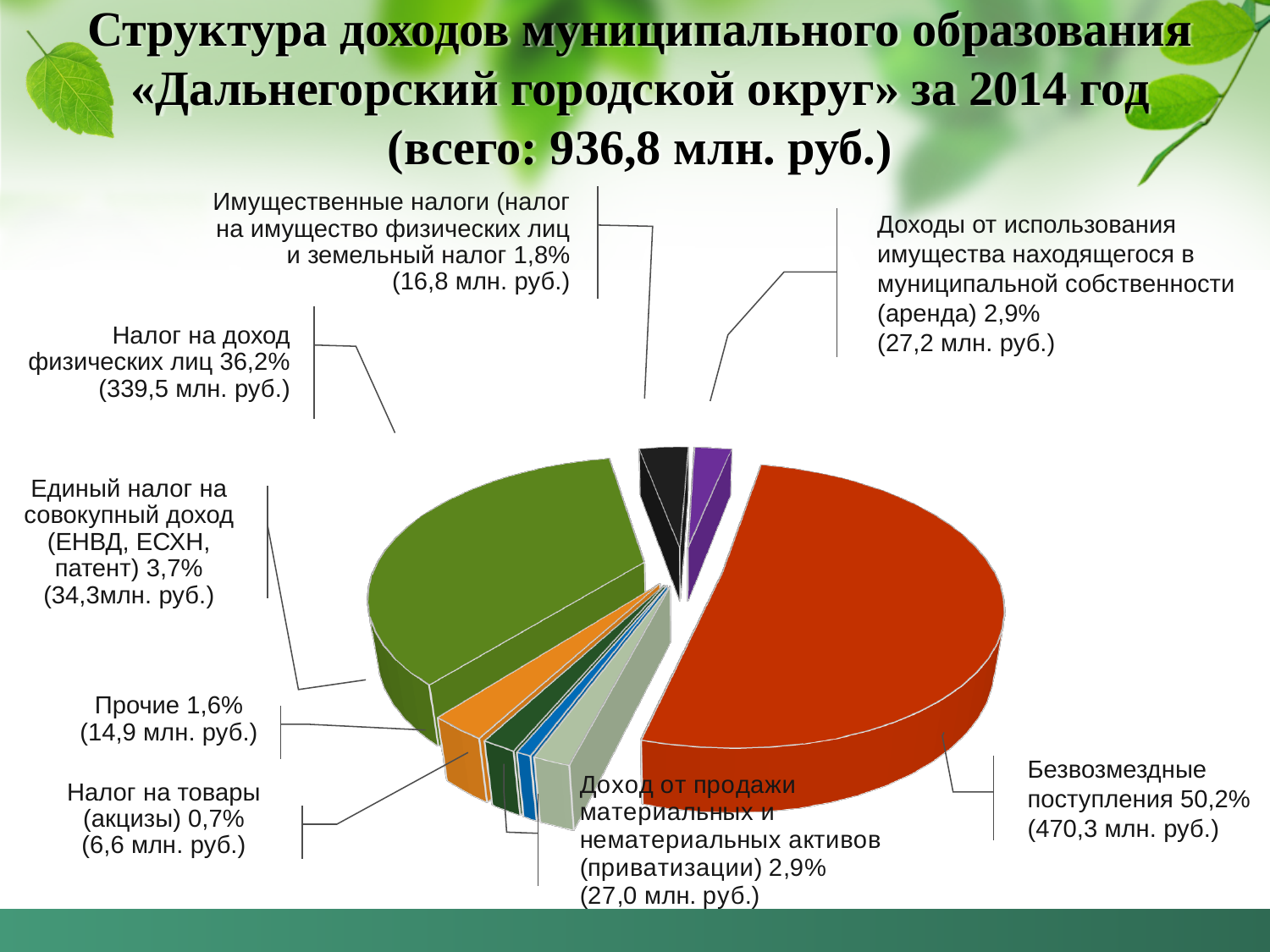
What is the difference in млн. руб. between "Безвозмездные поступления" and "Налог на доход физических лиц"? 130,8 млн. руб. How many categories (slices) does the pie chart have? 8 What kind of chart is shown on the slide? pie chart What is the value in млн. руб. for "Прочие"? 14,9 млн. руб. What share of the pie does "Безвозмездные поступления" represent? 50,2% What is the value in млн. руб. for "Доходы от использования имущества находящегося в муниципальной собственности (аренда)"? 27,2 млн. руб. What percentage share is shown for "Единый налог на совокупный доход (ЕНВД, ЕСХН, патент)"? 3,7% Which category has the largest share of the pie? Безвозмездные поступления Which is larger: "Имущественные налоги" or "Прочие"? Имущественные налоги What is the value in млн. руб. for "Налог на доход физических лиц"? 339,5 млн. руб. What total amount of income is stated in the chart title? 936,8 млн. руб. Which category has the smallest share of the pie? Налог на товары (акцизы)